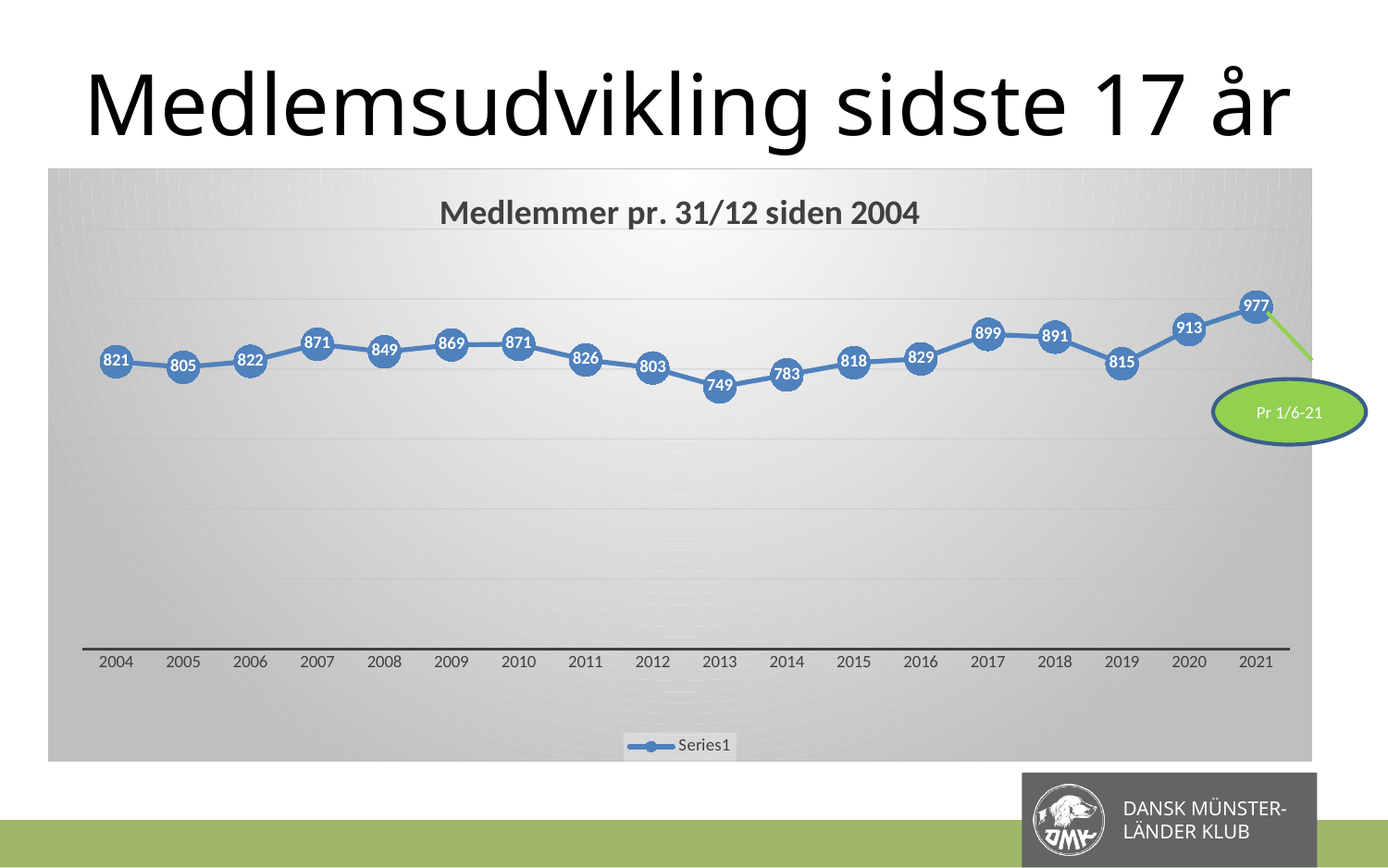
What is the title of the chart? Medlemmer pr. 31/12 siden 2004 What is the difference between the values for 2021 and 2020? 64 How many years are shown on the x axis? 18 Which year has the lowest value? 2013 Which year has the highest value? 2021 What is the value for 2013? 749 Do the values rise or fall from 2013 to 2017? rise How many series does the legend list? 1 What is the value for 2021? 977 What is the value for 2004? 821 Which is larger, the value for 2017 or the value for 2018? 2017 What kind of chart is shown? line chart